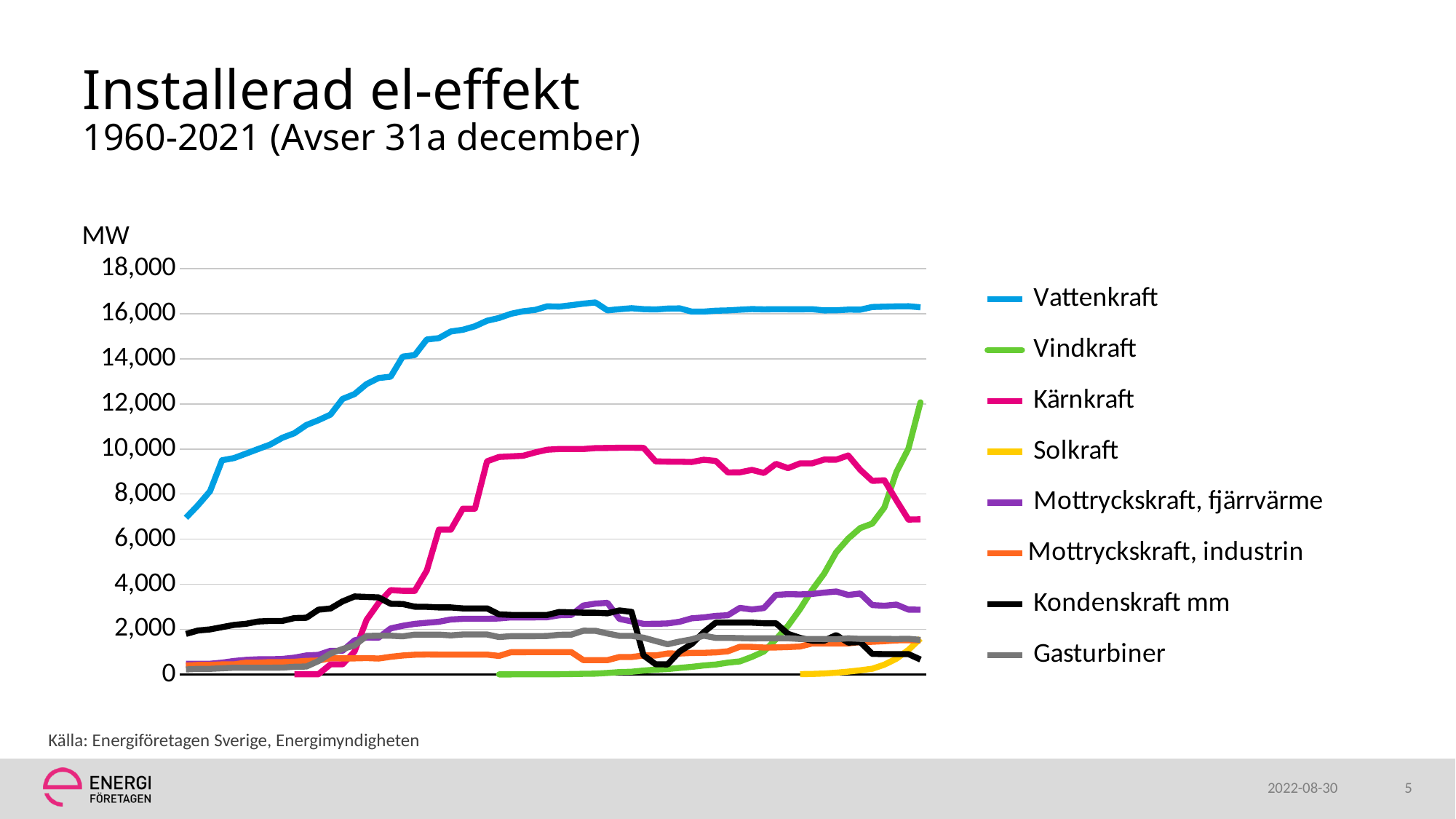
Is the final value for Solkraft greater or less than 2,000? less Does the Vindkraft line rise or fall toward the right end of the chart? rise What kind of chart is shown on the slide? line chart What unit is shown on the y axis of the chart? MW Does the Vattenkraft line overall rise or fall from left to right? rise What is the title of the chart on the slide? Installerad el-effekt Which series has the lowest value at the right end of the chart? Kondenskraft mm Which series has the highest values throughout the chart? Vattenkraft Is the final value for Vindkraft greater or less than 10,000? greater At the right end of the chart, which is larger: Vindkraft or Kärnkraft? Vindkraft How many series does the legend list? 8 Is the final value for Vattenkraft greater or less than 14,000? greater